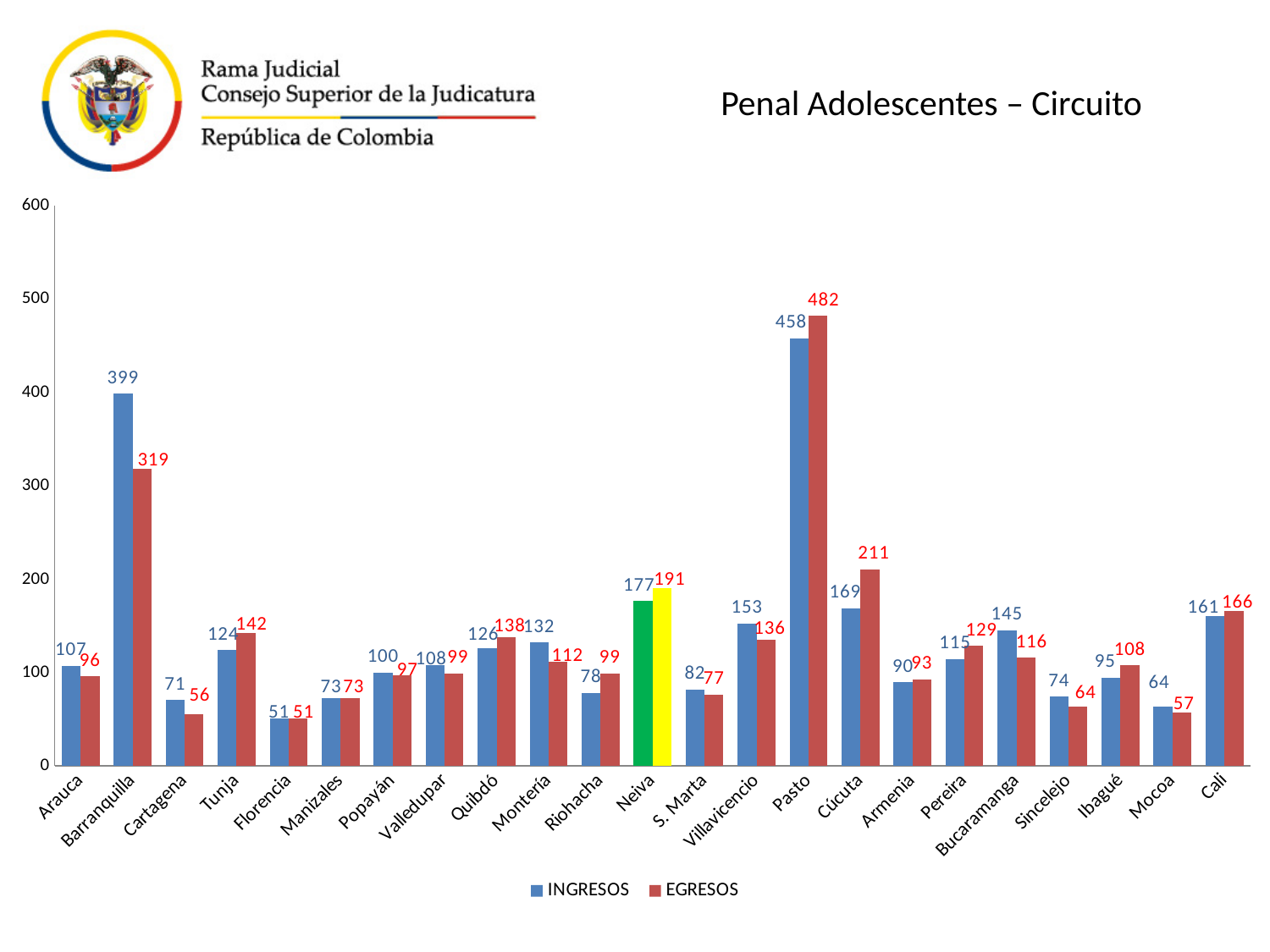
Which city has the lowest INGRESOS value? Florencia Which city has the highest EGRESOS value? Pasto What is the title of the chart? Penal Adolescentes – Circuito Is the EGRESOS value for Barranquilla greater or less than 300? greater What is the difference between INGRESOS and EGRESOS for Pasto? 24 Which is larger for Bucaramanga, INGRESOS or EGRESOS? INGRESOS How many cities are shown on the x axis? 23 How many series does the legend list? 2 What is the INGRESOS value for Neiva? 177 What kind of chart is shown on the slide? Bar chart What is the INGRESOS value for Barranquilla? 399 What is the EGRESOS value for Cúcuta? 211